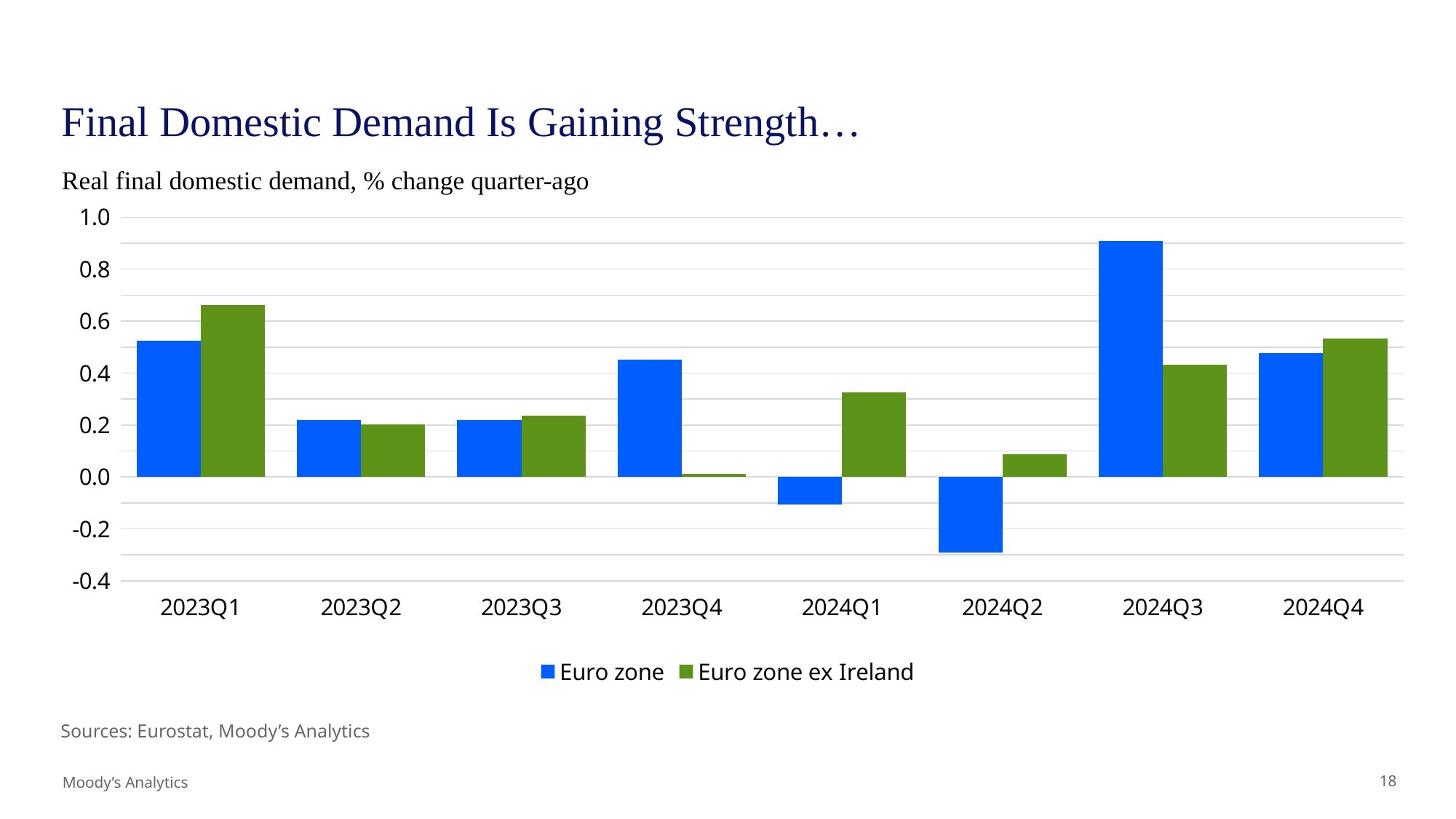
In 2023Q1, which series has the larger value, Euro zone or Euro zone ex Ireland? Euro zone ex Ireland Is the Euro zone value for 2024Q2 greater or less than -0.2? less How many series does the legend list? 2 How many quarters are shown on the x axis? 8 What kind of chart is shown on the slide? Bar chart In which quarter is the Euro zone value highest? 2024Q3 In which quarter is the Euro zone ex Ireland value highest? 2023Q1 In which quarter is the Euro zone ex Ireland value lowest? 2023Q4 In 2024Q3, which series has the larger value, Euro zone or Euro zone ex Ireland? Euro zone Is the Euro zone value for 2024Q3 greater or less than 0.8? greater What are the two series named in the legend? Euro zone; Euro zone ex Ireland In which quarter is the Euro zone value lowest? 2024Q2